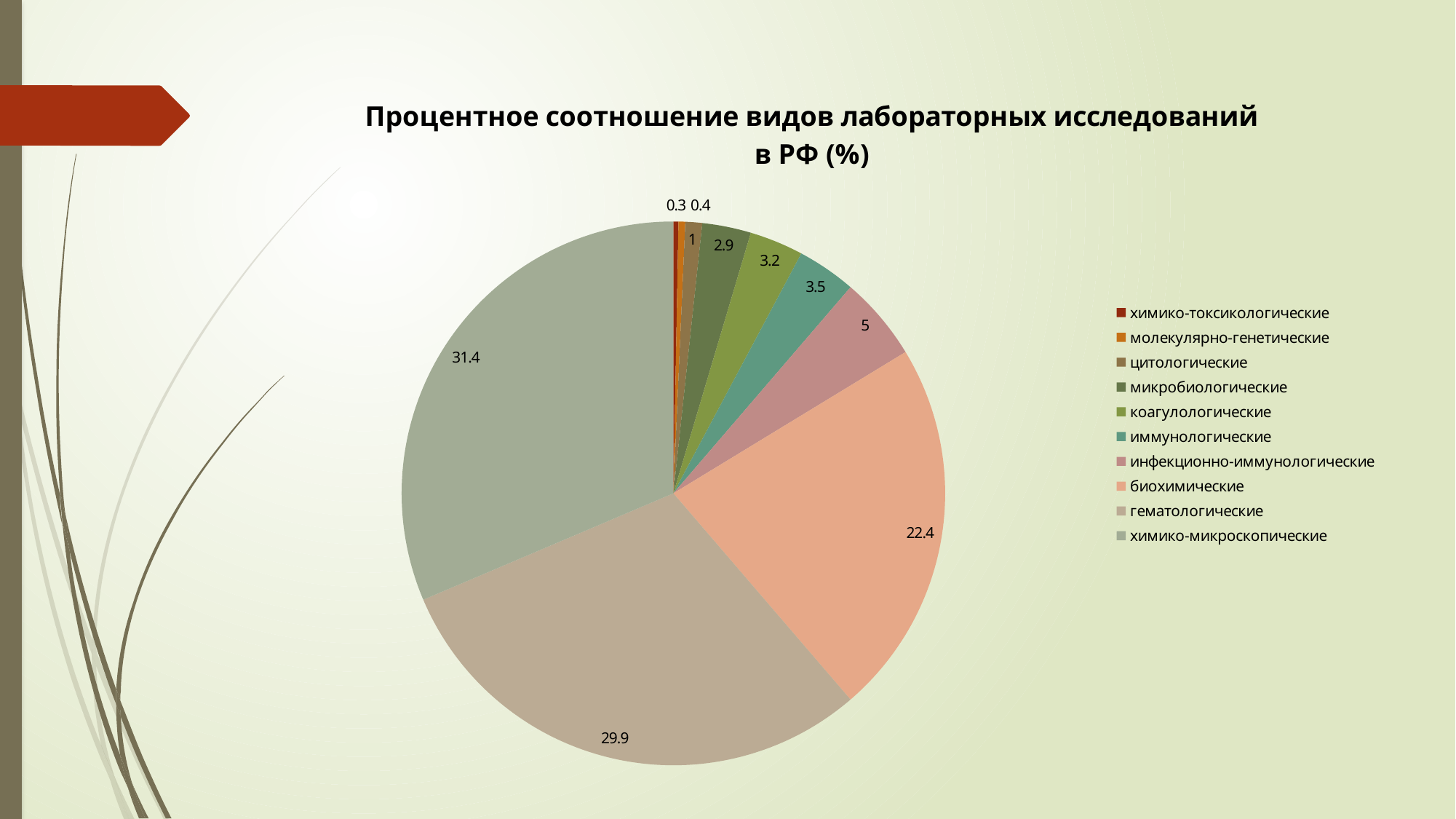
What is the value for микробиологические? 2.9 Which category has the largest share of the pie? химико-микроскопические What is the value for биохимические? 22.4 How many categories does the pie chart show? 10 What type of chart is shown on the slide? pie chart Which category has the smallest share of the pie? химико-токсикологические What is the value for инфекционно-иммунологические? 5 Which is larger, the value for иммунологические or the value for коагулологические? иммунологические What is the difference between the values for химико-микроскопические and гематологические? 1.5 What is the value for гематологические? 29.9 What is the difference between the values for биохимические and инфекционно-иммунологические? 17.4 What is the title of the chart? Процентное соотношение видов лабораторных исследований в РФ (%)